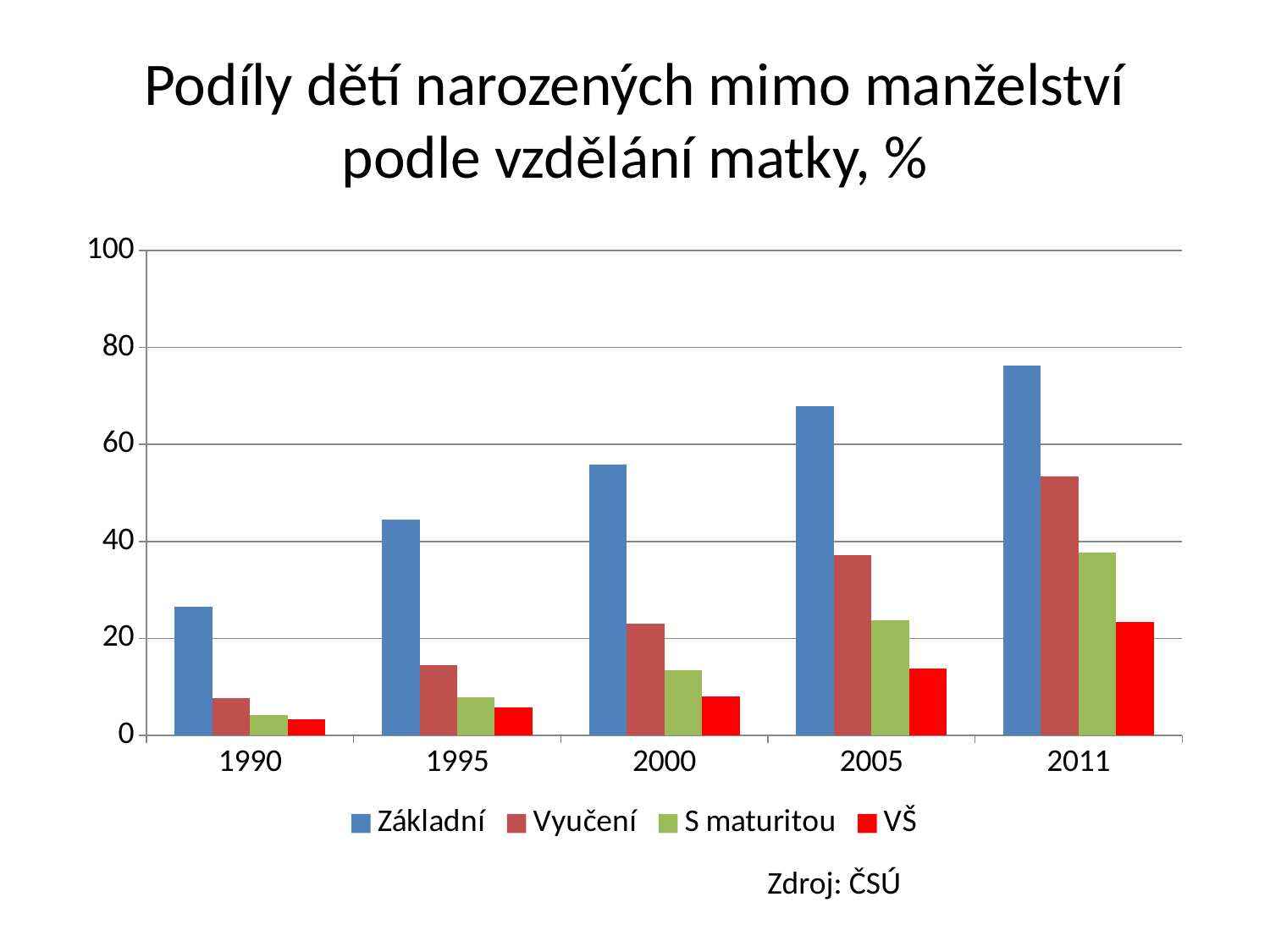
What colour are the bars for VŠ? red Which year has the lowest value for VŠ? 1990 Is the value for S maturitou in 2005 greater or less than 40? less How many series does the legend list? 4 Is the value for Vyučení in 2000 greater or less than 40? less Which is larger in 2005: Vyučení or VŠ? Vyučení What kind of chart is shown on the slide? bar chart Is the value for Základní in 1990 greater or less than 20? greater Which year has the highest value for Základní? 2011 How many years are shown on the x axis? 5 Do the values for Základní rise or fall from 1990 to 2011? rise